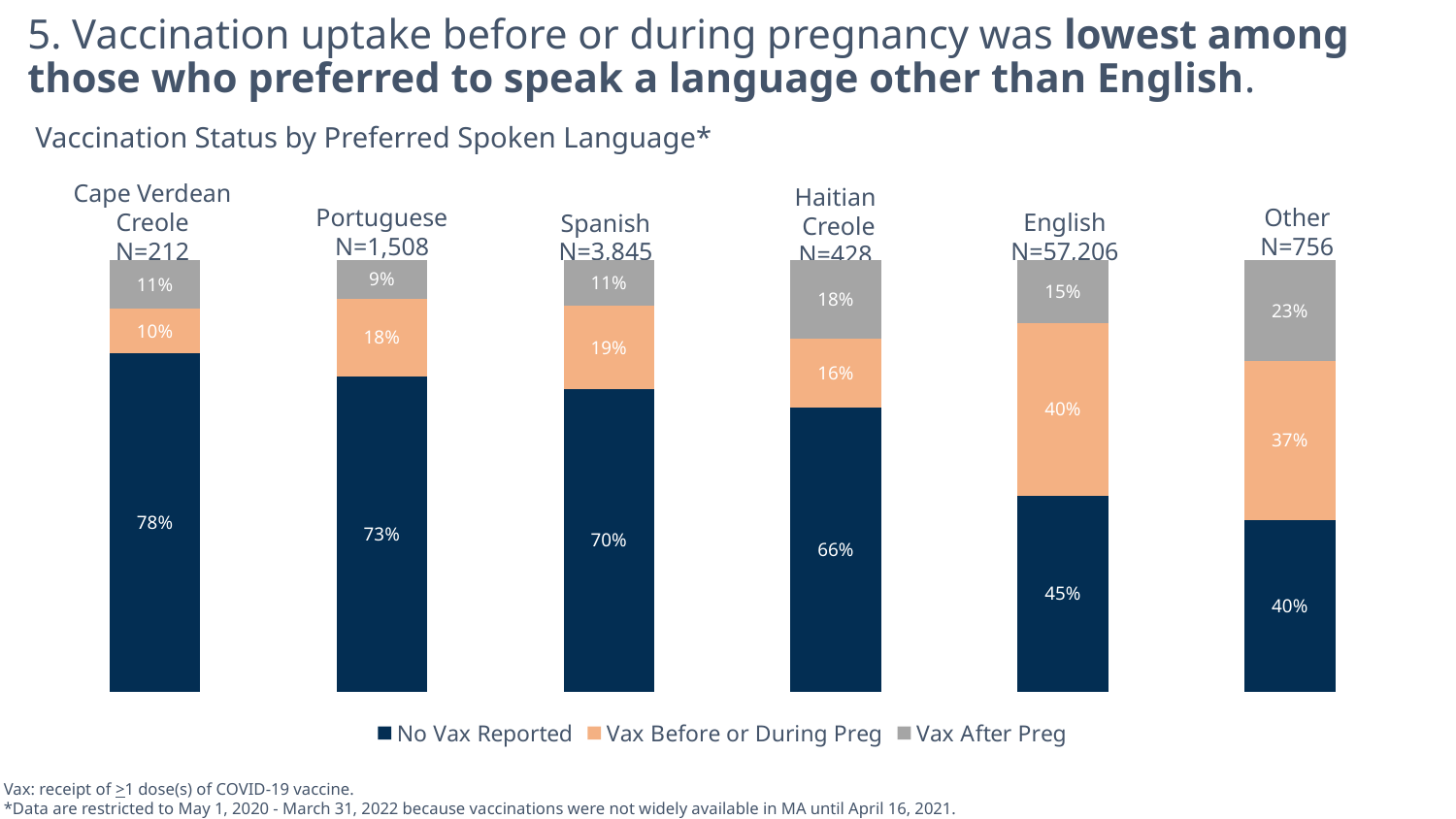
Which is larger: the Vax After Preg percentage for Haitian Creole or for Spanish? Haitian Creole What is the No Vax Reported percentage for Cape Verdean Creole? 78% How many language categories are shown in the chart? 6 What is the Vax Before or During Preg percentage for English? 40% How many series does the legend list? 3 What is the sample size (N) shown for Spanish? N=3,845 What is the Vax After Preg percentage for Other? 23% Which language category has the lowest Vax Before or During Preg percentage? Cape Verdean Creole What is the title of the chart? Vaccination Status by Preferred Spoken Language* What kind of chart is shown on the slide? Stacked bar chart Which language category has the highest No Vax Reported percentage? Cape Verdean Creole What is the difference between the No Vax Reported percentages for Portuguese and English? 28%